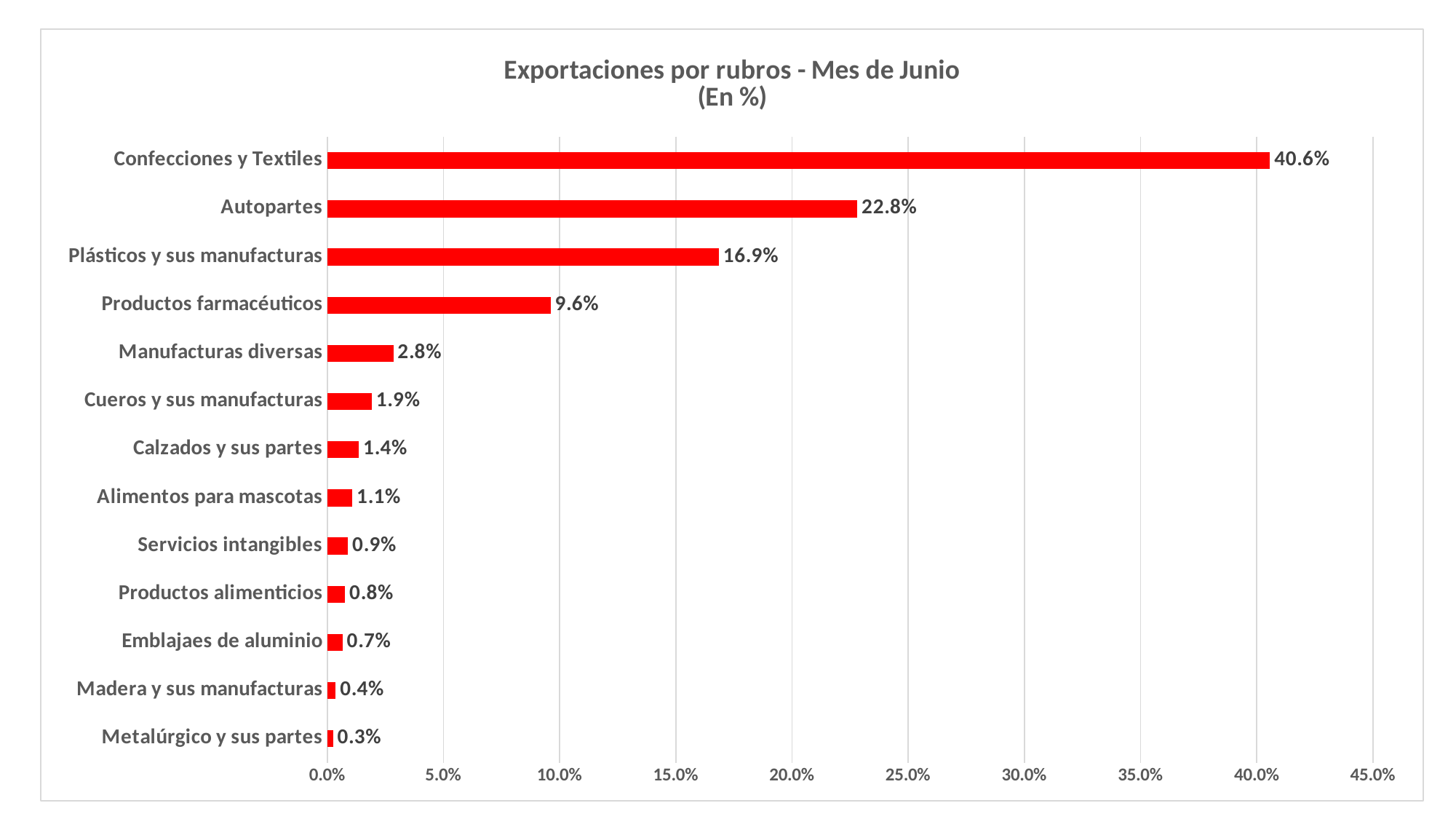
What is the value for Cueros y sus manufacturas? 1.9% What is the value for Autopartes? 22.8% What is the difference between the values for Confecciones y Textiles and Autopartes? 17.8% What is the difference between the values for Plásticos y sus manufacturas and Productos farmacéuticos? 7.3% What is the title of the chart? Exportaciones por rubros - Mes de Junio (En %) What kind of chart is shown on the slide? Bar chart Which category has the highest value? Confecciones y Textiles What is the value for Productos farmacéuticos? 9.6% Which category has the lowest value? Metalúrgico y sus partes How many categories are shown in the chart? 13 Is the value for Plásticos y sus manufacturas greater or less than 15.0%? greater Which is larger, the value for Manufacturas diversas or the value for Calzados y sus partes? Manufacturas diversas